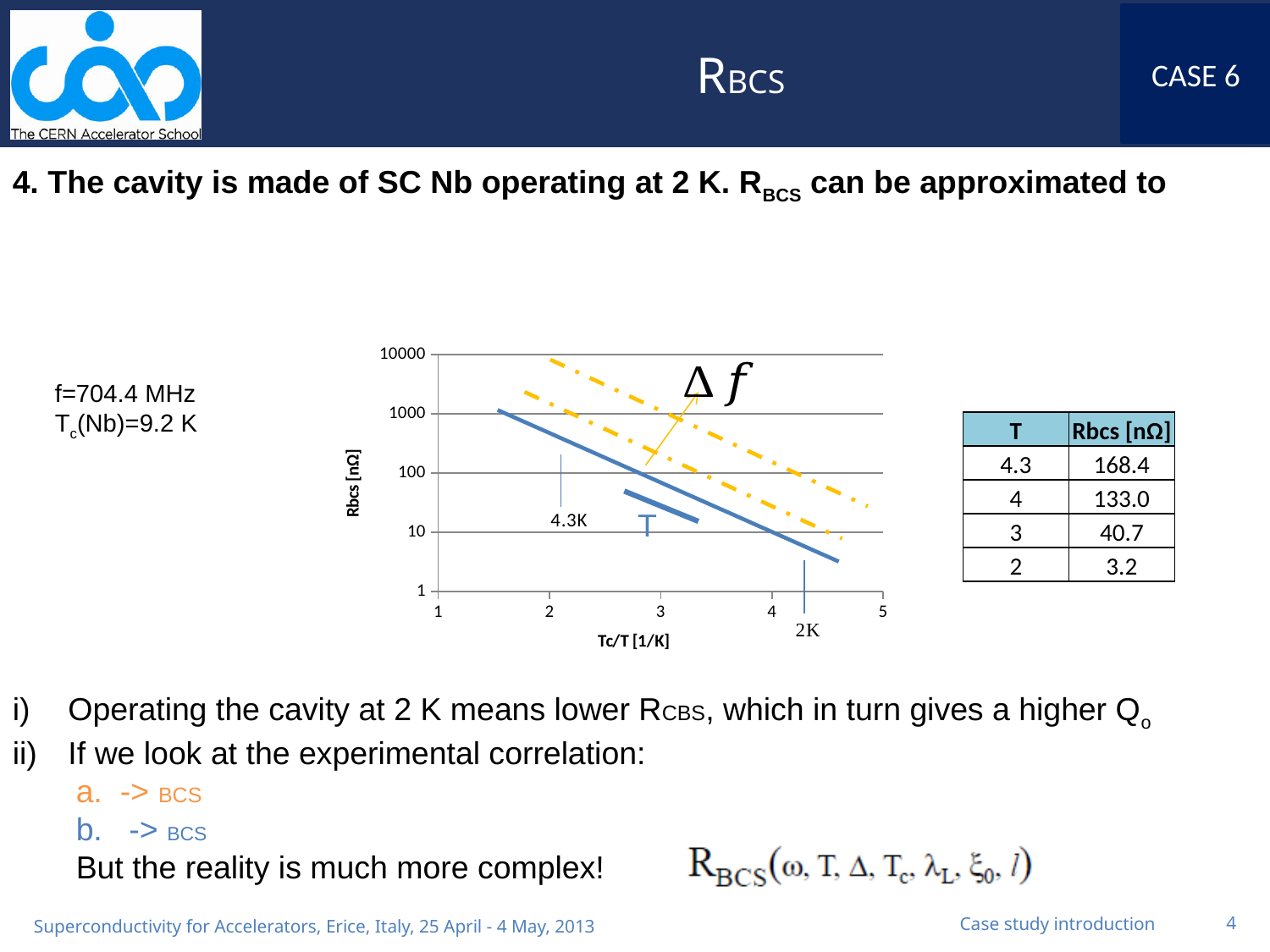
Is the value of the solid blue line at Tc/T = 3 greater or less than 10? greater Is the value of the solid blue line at Tc/T = 2 greater or less than 100? greater What is the label of the y axis of the chart? Rbcs [nΩ] What is the label of the x axis of the chart? Tc/T [1/K] What is the highest tick value shown on the y axis of the chart? 10000 According to the table next to the chart, what is the difference in Rbcs between T = 4 and T = 3? 92.3 According to the table next to the chart, what is Rbcs at T = 2? 3.2 What kind of chart is shown on the slide? line chart According to the table next to the chart, what is Rbcs at T = 4.3? 168.4 According to the table next to the chart, which temperature has the lowest Rbcs? 2 Is the value of the solid blue line at Tc/T = 3 greater or less than 100? less Does the solid blue line rise or fall as Tc/T increases along the x axis? fall